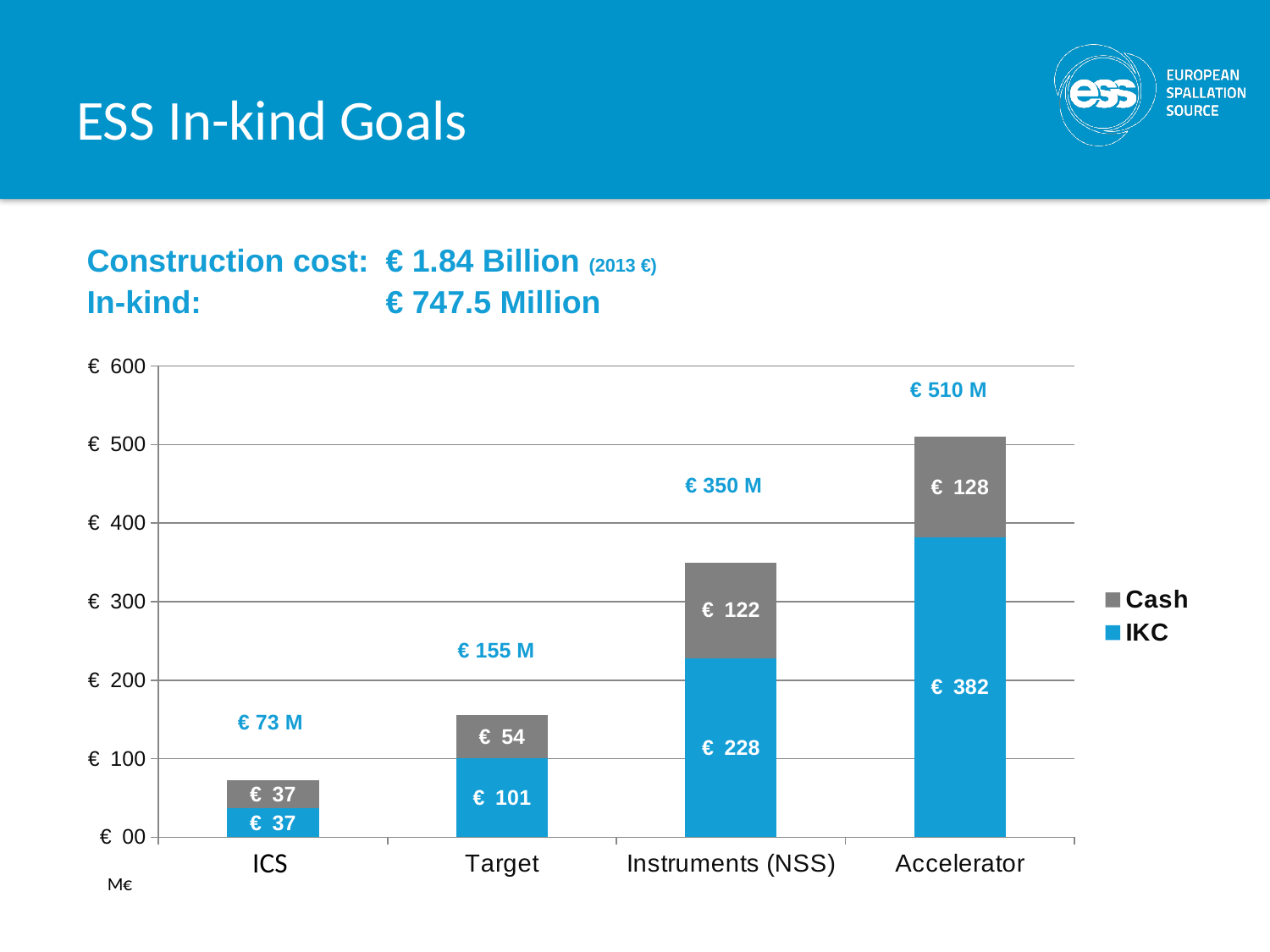
What is the total of the stacked bar for Target? € 155 M What is the difference between the IKC values for Accelerator and Instruments (NSS)? € 154 Which category has the lowest Cash value? ICS What is the IKC value for Target? € 101 How many categories are shown on the x axis? 4 Which category has the highest IKC value? Accelerator What is the IKC value for Accelerator? € 382 Which is larger, the Cash value for Target or the Cash value for Instruments (NSS)? Instruments (NSS) What is the Cash value for ICS? € 37 What is the Cash value for Instruments (NSS)? € 122 What kind of chart is shown on the slide? Stacked bar chart How many series does the legend list? 2